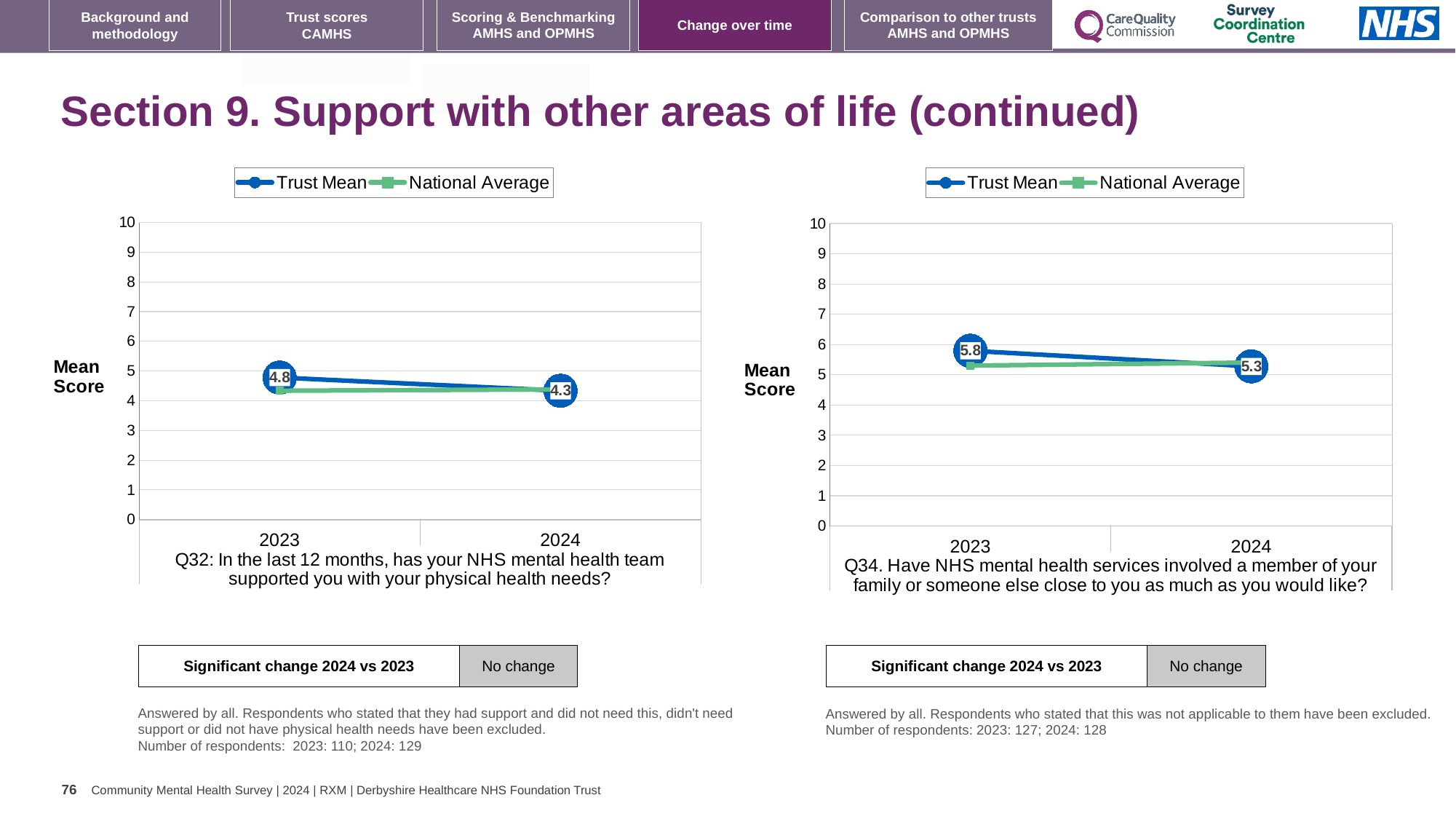
In the Q32 chart (left), is the National Average for 2023 greater or less than 5? less In the Q32 chart (left), what is the Trust Mean for 2024? 4.3 In the Q32 chart (left), which year has the higher Trust Mean, 2023 or 2024? 2023 In the Q34 chart (right), what is the difference between the Trust Mean in 2023 and in 2024? 0.5 What kind of chart is the Q32 chart (left)? line chart In the Q34 chart (right), does the Trust Mean rise or fall from 2023 to 2024? fall How many series does the legend of the Q34 chart (right) list? 2 How many years are shown on the x axis of the Q34 chart (right)? 2 In the Q32 chart (left), by how much did the Trust Mean change from 2023 to 2024? 0.5 In the Q34 chart (right), what is the Trust Mean for 2023? 5.8 In the Q32 chart (left), what is the Trust Mean for 2023? 4.8 In the Q34 chart (right), what is the Trust Mean for 2024? 5.3